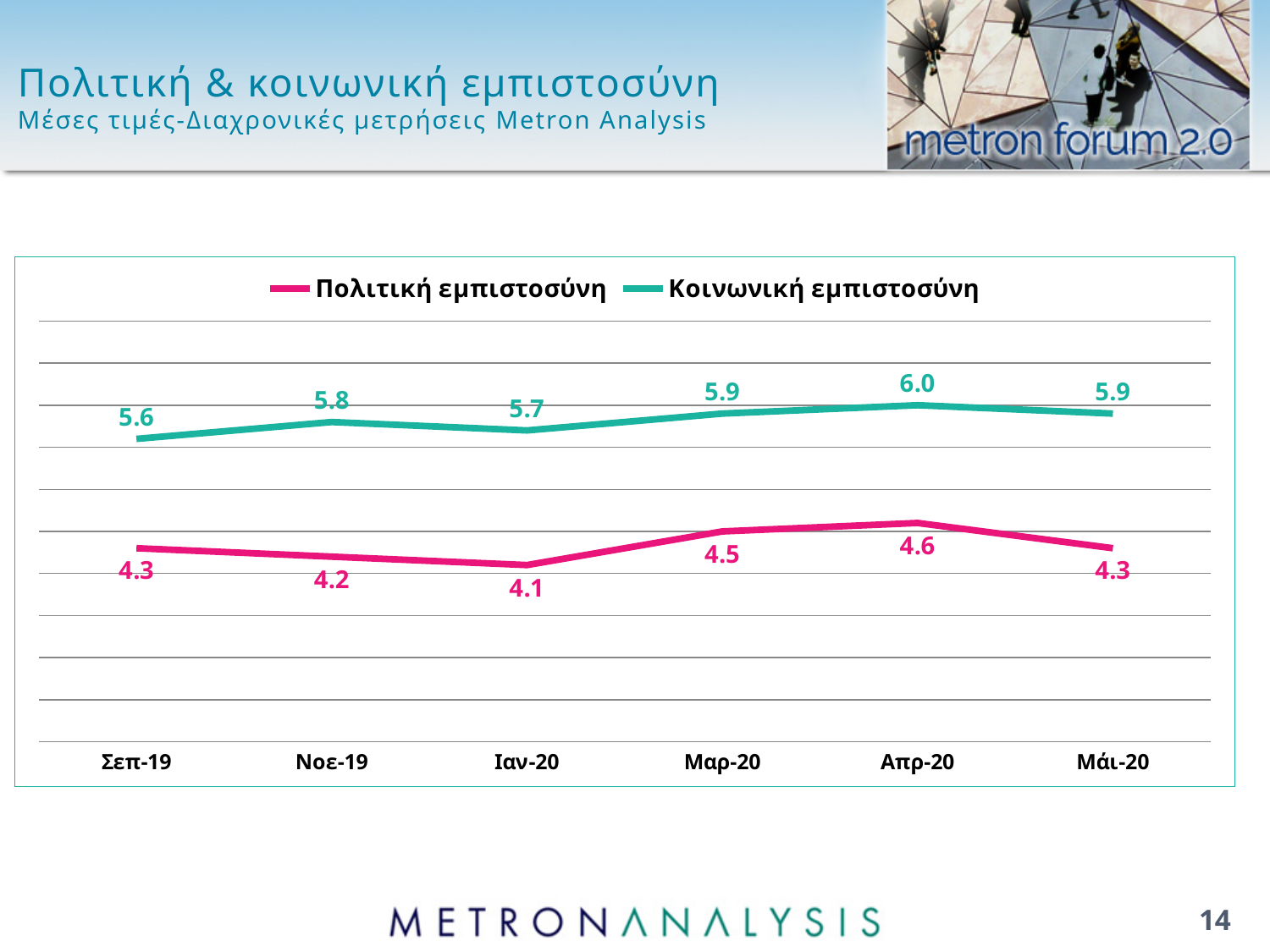
What kind of chart is shown on the slide? Line chart How many time periods are shown on the x axis? 6 Which is larger in Νοε-19: Πολιτική εμπιστοσύνη or Κοινωνική εμπιστοσύνη? Κοινωνική εμπιστοσύνη How many series does the legend list? 2 What is the value of Πολιτική εμπιστοσύνη in Σεπ-19? 4.3 What is the value of Πολιτική εμπιστοσύνη in Ιαν-20? 4.1 What is the difference between Κοινωνική εμπιστοσύνη and Πολιτική εμπιστοσύνη in Μάι-20? 1.6 What colour is the line for Πολιτική εμπιστοσύνη? Pink/magenta In which period is Πολιτική εμπιστοσύνη highest? Απρ-20 What is the value of Κοινωνική εμπιστοσύνη in Απρ-20? 6.0 Does Πολιτική εμπιστοσύνη rise or fall from Ιαν-20 to Απρ-20? Rise In which period is Κοινωνική εμπιστοσύνη lowest? Σεπ-19